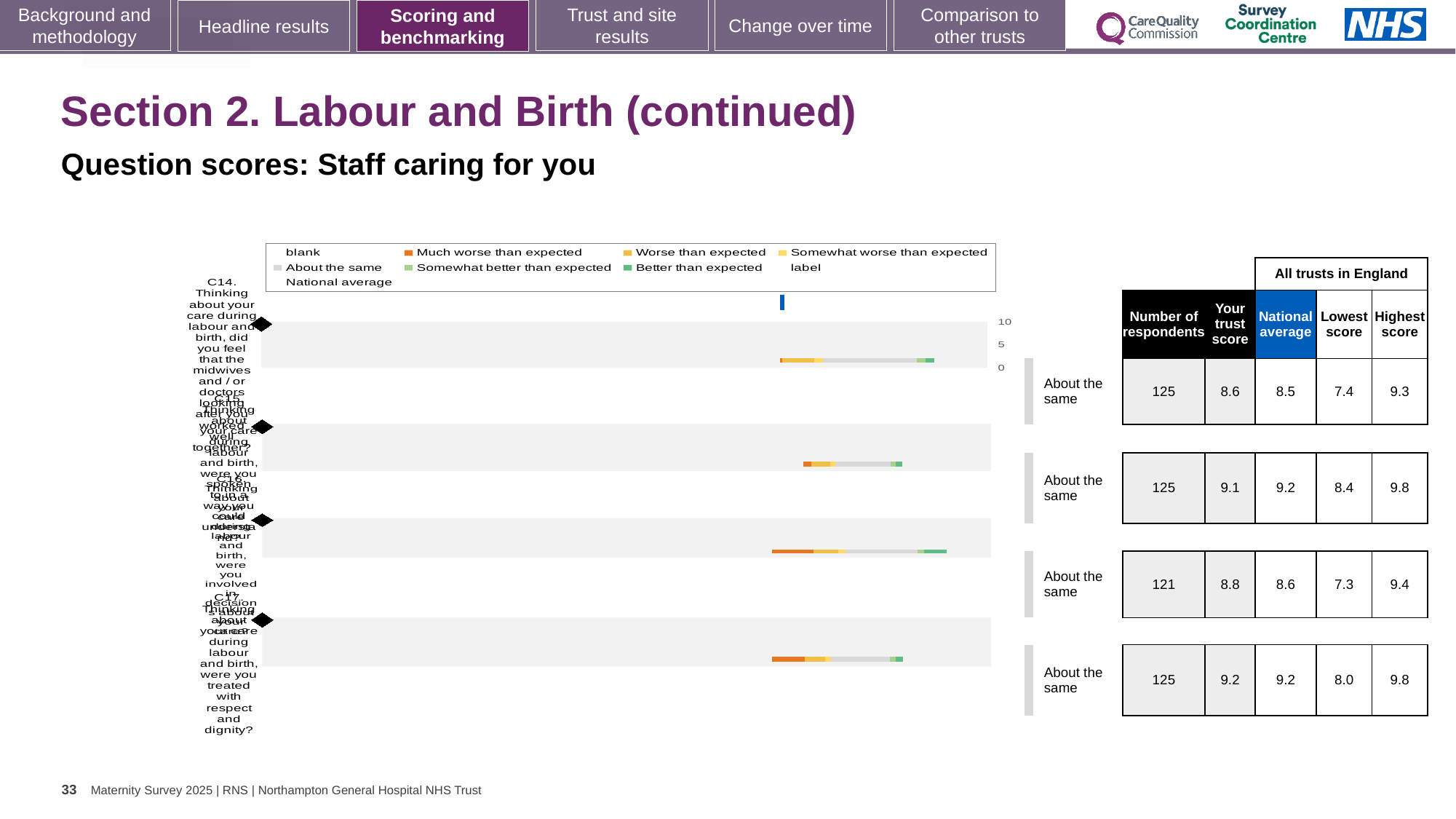
What is the last legend entry listed in the chart's legend? National average In the table beside the chart, what is the 'Number of respondents' in the third row? 121 In the table beside the chart, is the 'Your trust score' in the fourth row (9.2) larger or smaller than the 'Your trust score' in the first row (8.6)? larger What kind of chart is shown on the slide? bar chart Which legend entry is shown in grey in the chart? About the same What benchmark label is shown next to each of the four bars in the chart? About the same How many entries does the chart's legend list? 9 How many bars (question rows) does the chart show? 4 In the table beside the chart, what is the difference between the 'Highest score' and 'Lowest score' in the first row? 1.9 In the table beside the chart, what is the 'Highest score' in the second row? 9.8 In the table beside the chart, what is the 'Your trust score' in the first row? 8.6